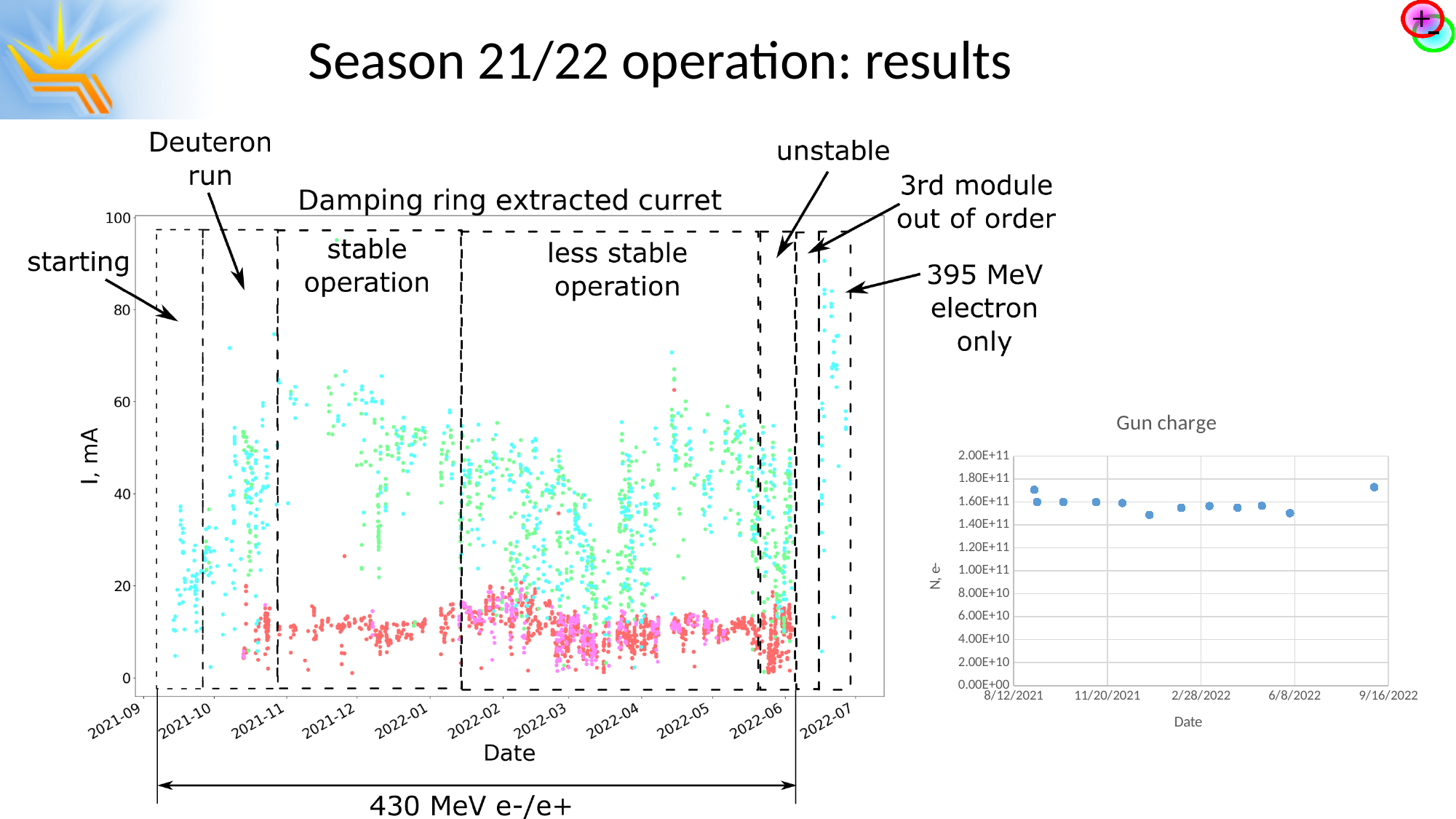
What kind of chart is the "Gun charge" chart? scatter chart On the "Damping ring extracted curret" chart, what is the label of the y axis? I, mA On the "Gun charge" chart, what is the highest tick value shown on the y axis? 2.00E+11 On the "Damping ring extracted curret" chart, what operating phase is labelled between 2021-11 and 2022-01? stable operation On the "Gun charge" chart, is the highest plotted value greater or less than 1.80E+11? less On the "Gun charge" chart, are all plotted values greater or less than 1.20E+11? greater On the "Gun charge" chart, what is the label of the x axis? Date On the "Damping ring extracted curret" chart, what is the highest tick value shown on the y axis? 100 What kind of chart is the "Damping ring extracted curret" chart? scatter chart On the "Gun charge" chart, is the lowest plotted value greater or less than 1.40E+11? greater On the "Gun charge" chart, what is the first date tick shown on the x axis? 8/12/2021